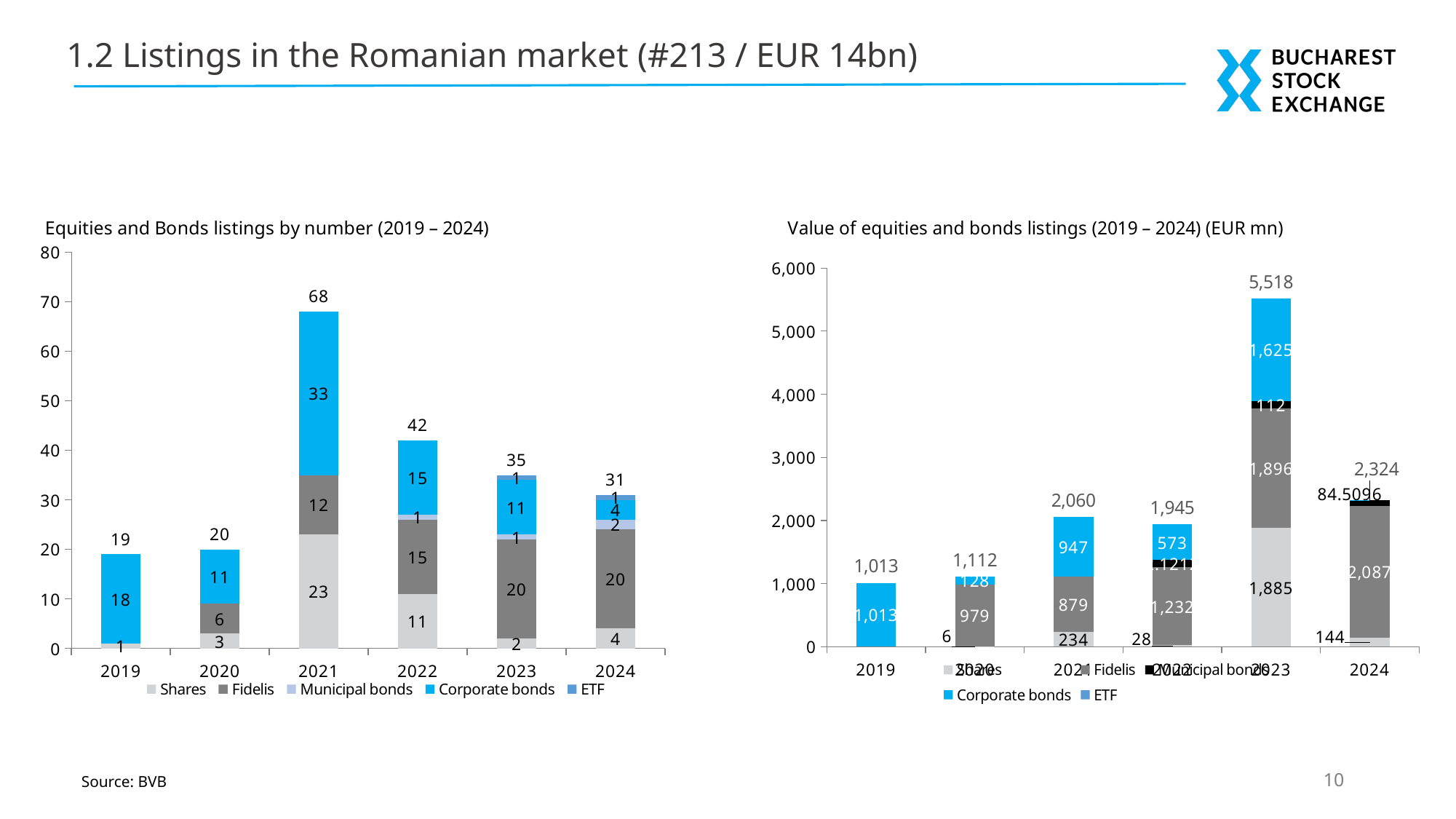
In the 'Equities and Bonds listings by number' chart, how many years are shown on the x axis? 6 In the 'Value of equities and bonds listings' chart, what is the value of Fidelis listings in 2022? 1,232 In the 'Equities and Bonds listings by number' chart, what is the total number of listings in 2021? 68 In the 'Equities and Bonds listings by number' chart, how many series does the legend list? 5 In the 'Equities and Bonds listings by number' chart, which year has the highest total number of listings? 2021 In the 'Value of equities and bonds listings' chart, is the total value for 2023 greater or less than 5,000? greater In the 'Value of equities and bonds listings' chart, which is larger: the total value for 2021 or for 2022? 2021 In the 'Equities and Bonds listings by number' chart, which year has the lowest total number of listings? 2019 What kind of chart is the 'Value of equities and bonds listings' chart? Stacked bar chart In the 'Value of equities and bonds listings' chart, what is the total value for 2023? 5,518 In the 'Equities and Bonds listings by number' chart, how many Fidelis listings were there in 2023? 20 In the 'Equities and Bonds listings by number' chart, what is the difference between the total listings in 2021 and 2022? 26